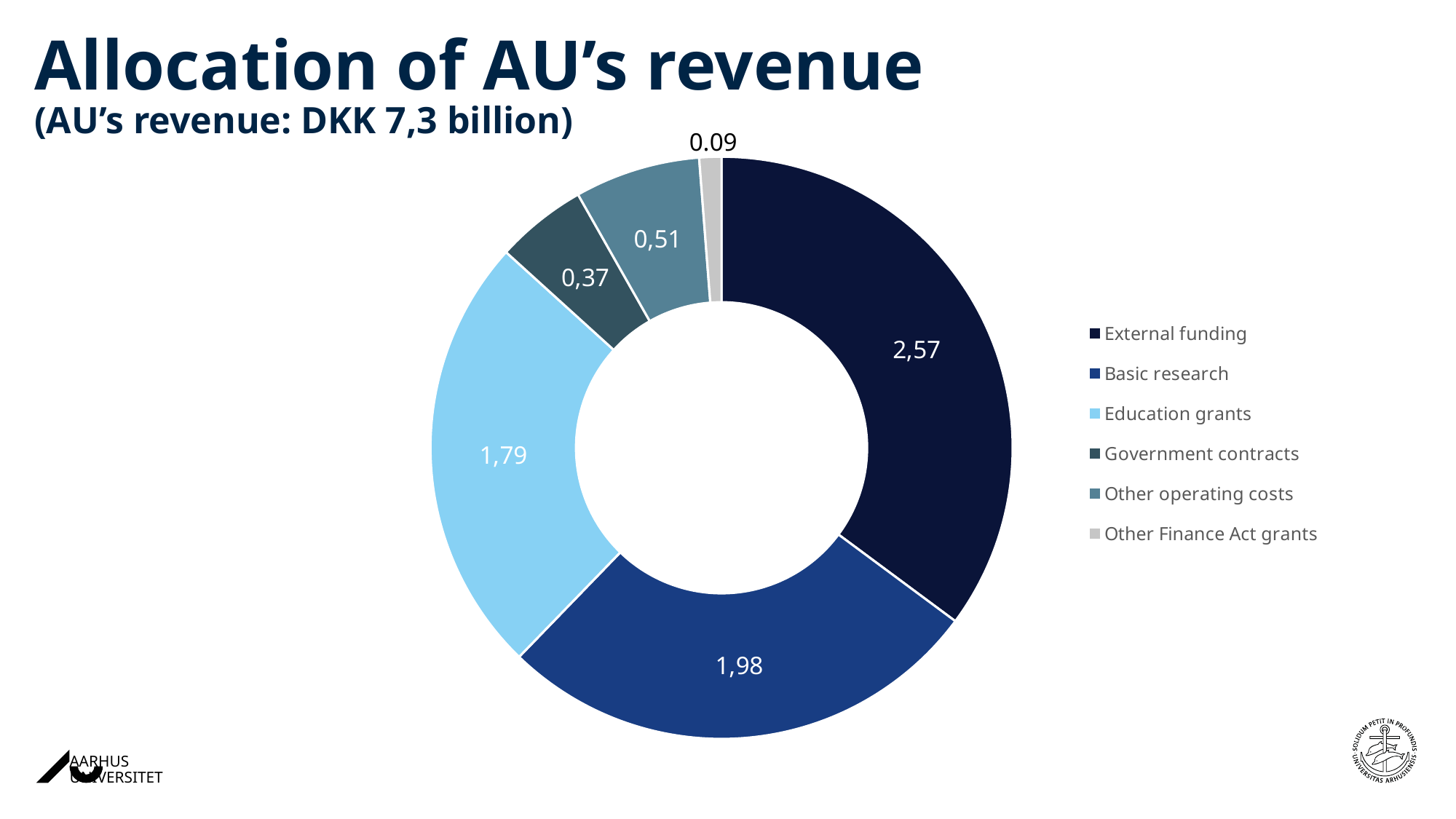
What is the value shown for Education grants? 1,79 How many categories does the chart show? 6 What is the value shown for Other operating costs? 0,51 Which is larger, Other operating costs or Government contracts? Other operating costs What kind of chart is shown on the slide? doughnut chart What is the value shown for Basic research? 1,98 Which category has the smallest value? Other Finance Act grants What is the value shown for Government contracts? 0,37 Which category has the largest value? External funding What is the difference between the values for External funding and Basic research? 0,59 What is the value shown for Other Finance Act grants? 0.09 What is the value shown for External funding? 2,57